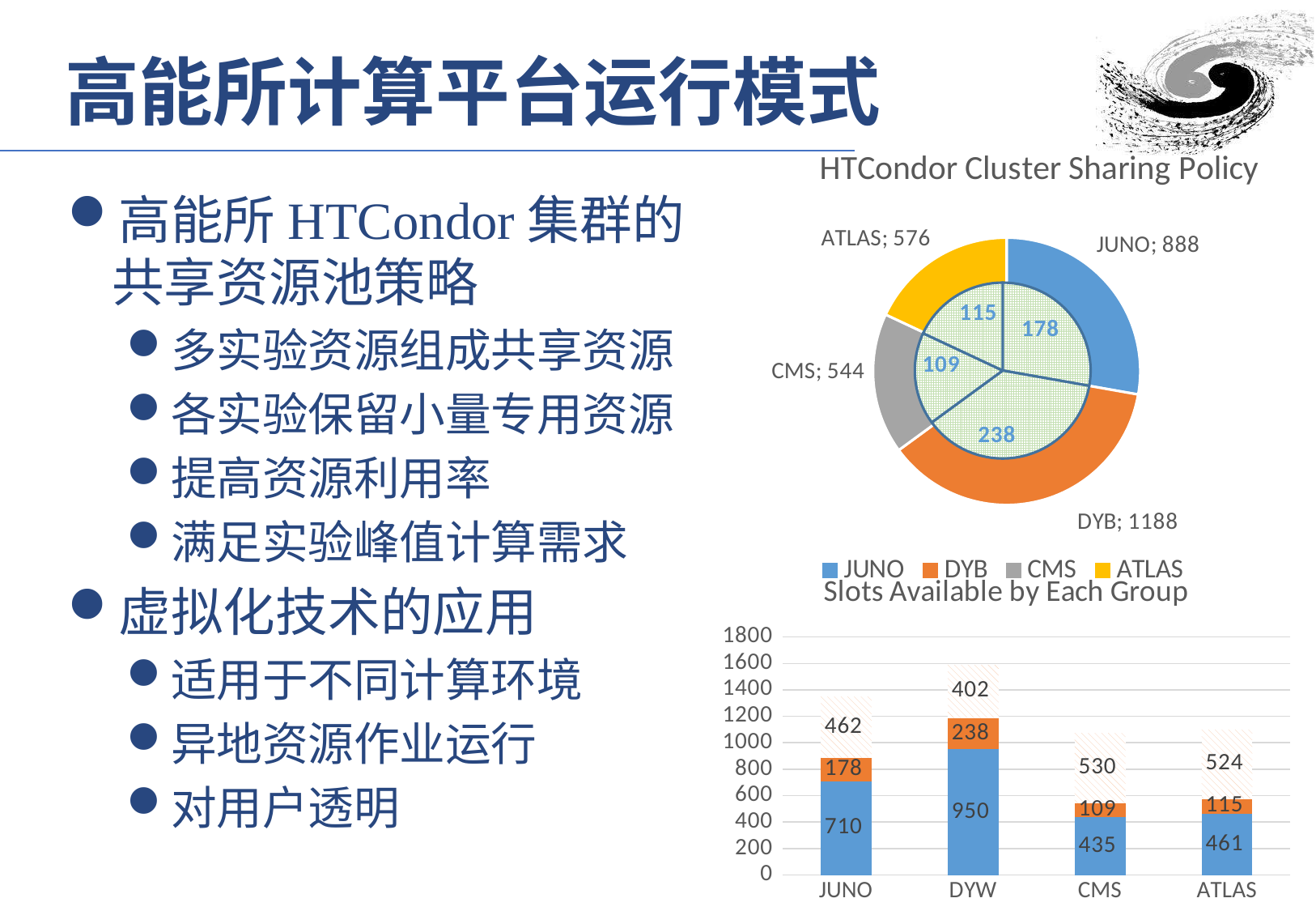
In the HTCondor Cluster Sharing Policy chart, what is the value for JUNO? 888 In the Slots Available by Each Group chart, what is the value of the blue segment for DYW? 950 In the HTCondor Cluster Sharing Policy chart, what is the difference between the DYB value and the JUNO value? 300 What kind of chart is the HTCondor Cluster Sharing Policy chart? Pie chart In the Slots Available by Each Group chart, what is the value of the orange segment for CMS? 109 In the HTCondor Cluster Sharing Policy chart, how many groups does the legend list? 4 In the HTCondor Cluster Sharing Policy chart, which group has the smallest value in the outer ring? CMS In the HTCondor Cluster Sharing Policy chart, what is the value for DYB? 1188 In the Slots Available by Each Group chart, is the blue segment for ATLAS larger or smaller than the blue segment for JUNO? Smaller In the Slots Available by Each Group chart, which group has the tallest stacked bar? DYW In the Slots Available by Each Group chart, how many groups are shown on the x axis? 4 In the Slots Available by Each Group chart, what is the total of the stacked bar for JUNO? 1350